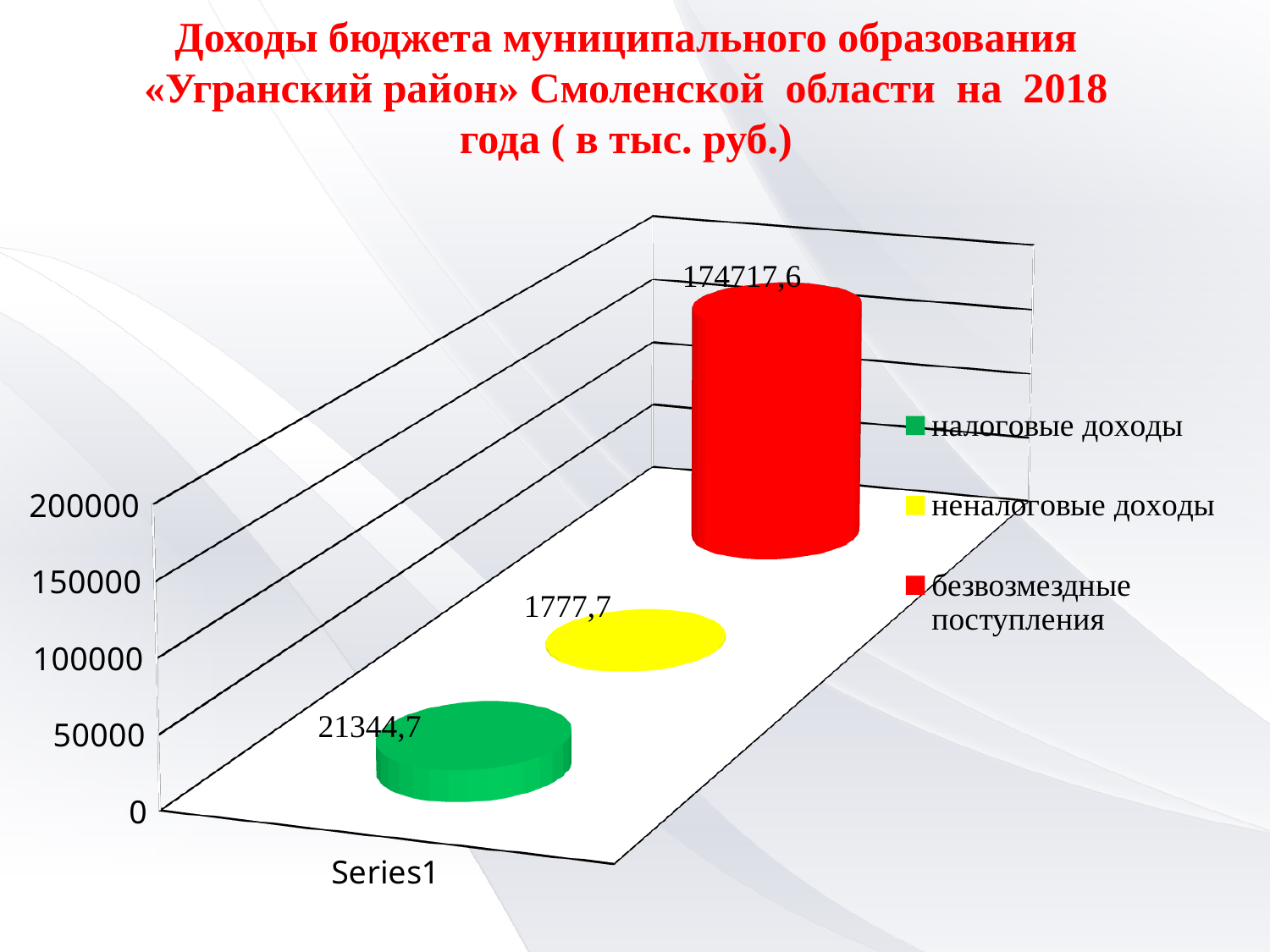
What is the value for налоговые доходы? 21344,7 What is the difference between налоговые доходы and неналоговые доходы? 19567 Is the value for безвозмездные поступления greater or less than 150000? greater Which is larger, налоговые доходы or неналоговые доходы? налоговые доходы Which series has the highest value? безвозмездные поступления How many series does the legend list? 3 What is the value for неналоговые доходы? 1777,7 Which series has the lowest value? неналоговые доходы What is the value for безвозмездные поступления? 174717,6 What is the difference between безвозмездные поступления and налоговые доходы? 153372,9 What colour represents безвозмездные поступления in the legend? red What kind of chart is shown on the slide? bar chart